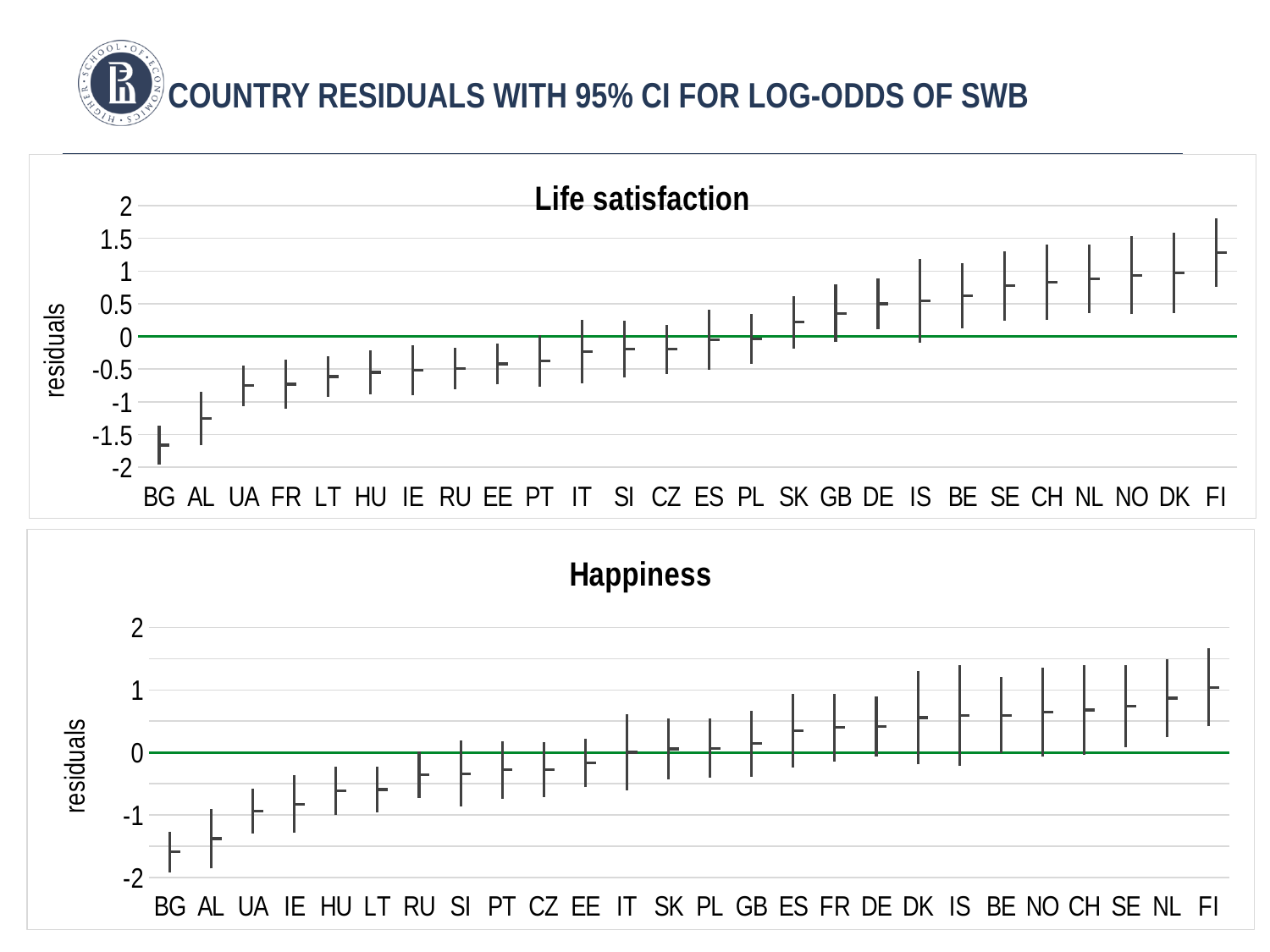
In the Life satisfaction chart, which has the larger residual, DK or AL? DK In the Happiness chart, is the residual for UA greater or less than 0? less How many countries are shown in the Life satisfaction chart? 26 In the Life satisfaction chart, which country has the lowest residual? BG In the Life satisfaction chart, which country has the highest residual? FI In the Happiness chart, which country has the highest residual? FI In the Life satisfaction chart, is the residual for FI greater or less than 1? greater In the Happiness chart, is the residual for BG greater or less than -1? less In the Happiness chart, which country has the lowest residual? BG How many countries are shown in the Happiness chart? 26 What is the label on the vertical axis of the Happiness chart? residuals